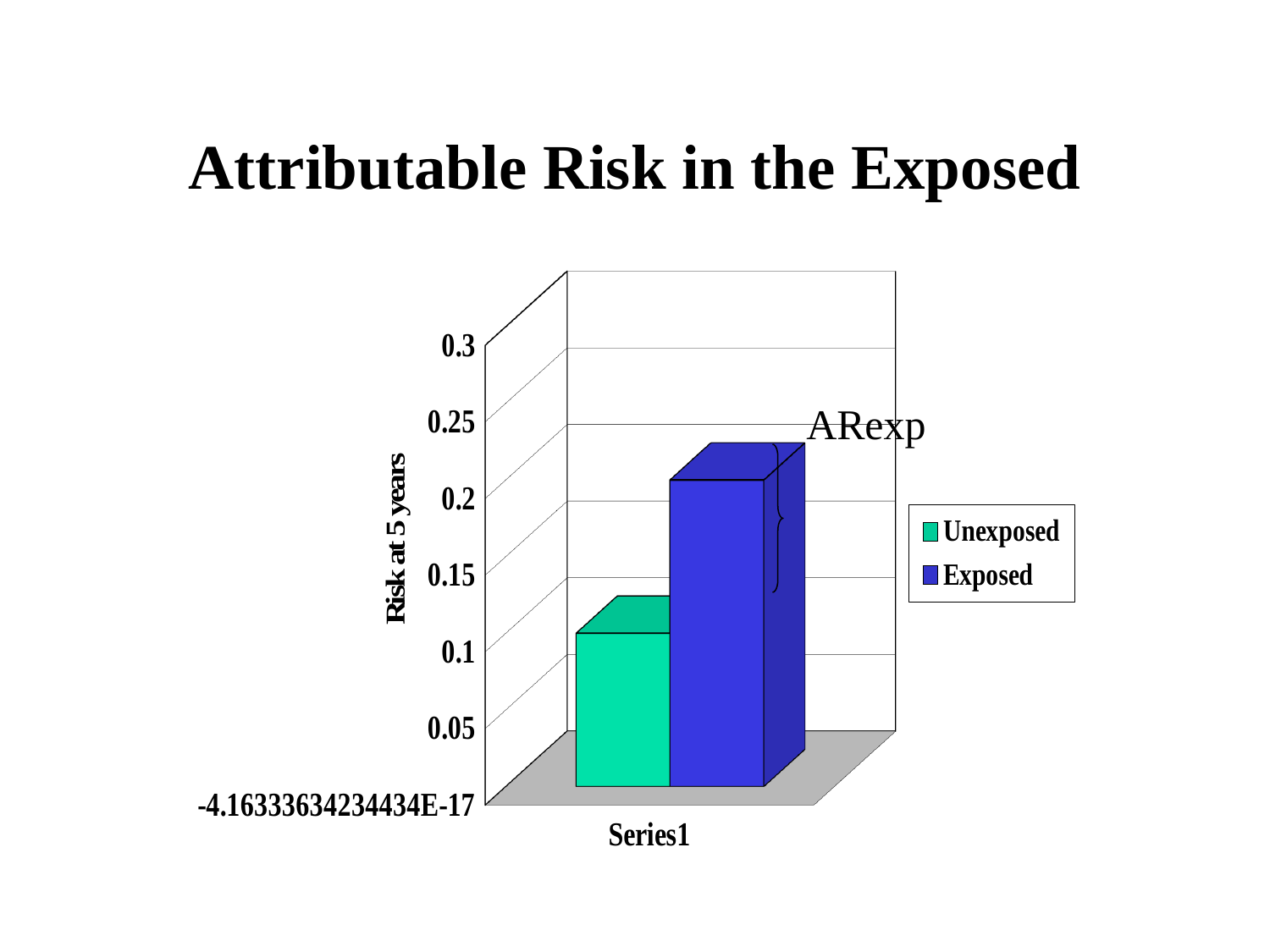
Is the value for Unexposed greater or less than 0.15? less Which series has the highest risk at 5 years? Exposed How many categories are shown on the horizontal axis? 1 What is the title of the vertical axis? Risk at 5 years Is the value for Exposed greater or less than 0.15? greater Is the value for Unexposed greater or less than 0.05? greater What kind of chart is shown on the slide? bar chart What are the two series named in the legend? Unexposed and Exposed Which series has the taller bar, Unexposed or Exposed? Exposed Which series has the lowest risk at 5 years? Unexposed How many series does the legend list? 2